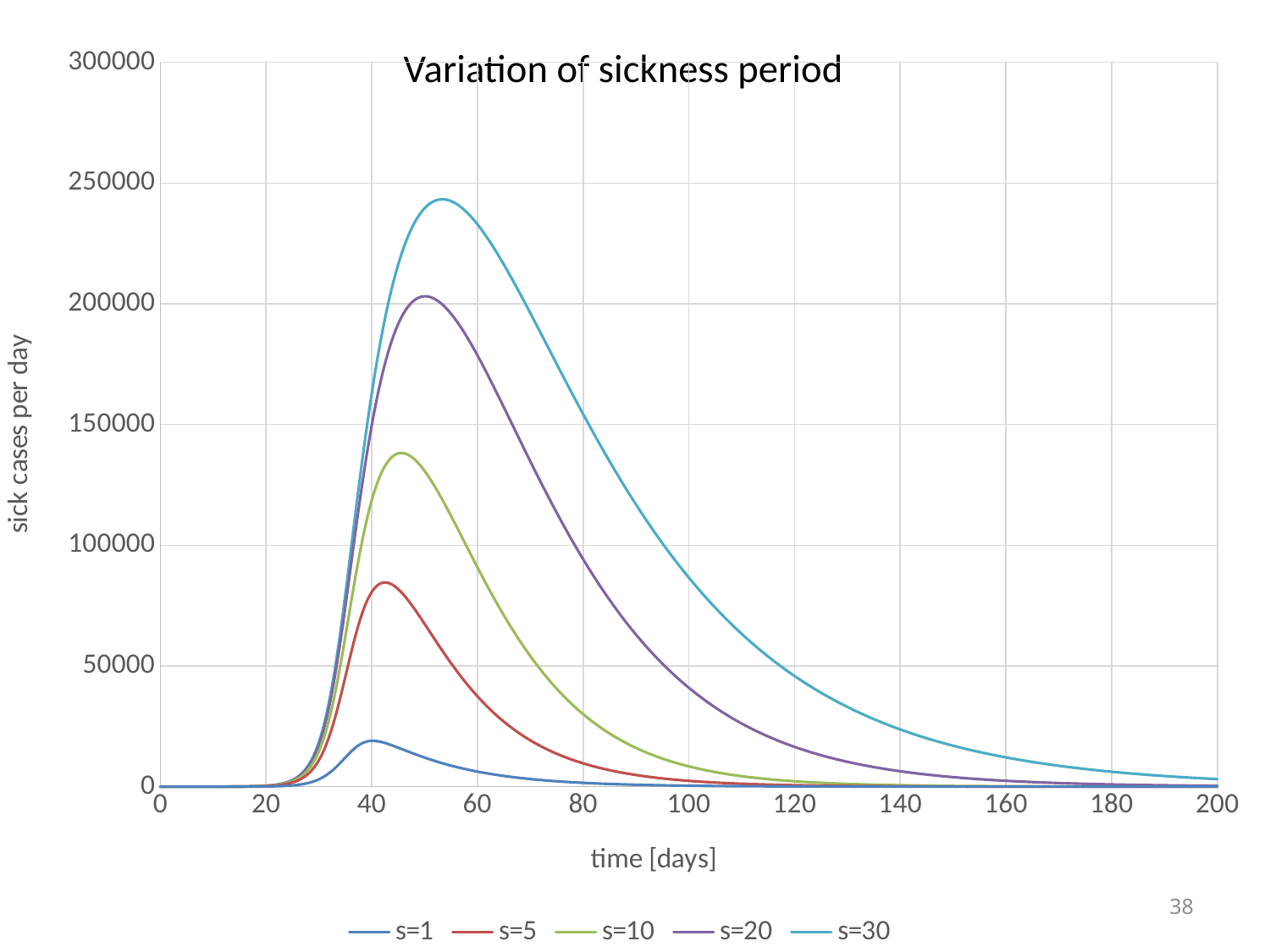
Is the peak value for s=5 greater or less than 100000? less Which series reaches a higher peak, s=10 or s=20? s=20 What is the title of the chart? Variation of sickness period After day 60, do the values for s=30 rise or fall as time increases? fall How many series does the legend list? 5 Is the peak value for s=20 greater or less than 250000? less Which series reaches the highest peak of sick cases per day? s=30 Which series has the lowest peak of sick cases per day? s=1 Is the peak value for s=30 greater or less than 200000? greater What kind of chart is shown on the slide? line chart What is the label of the vertical axis? sick cases per day